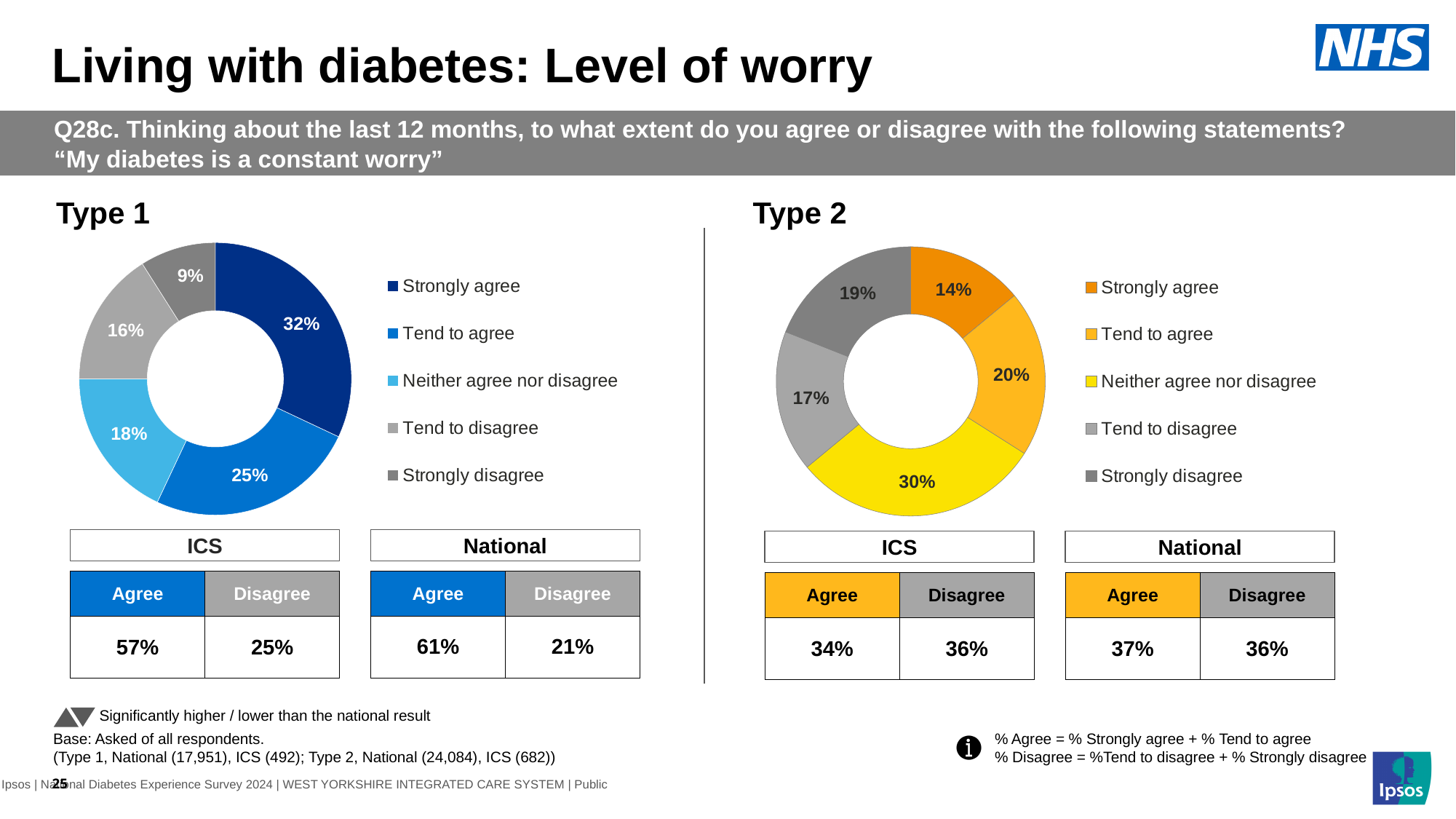
In the Type 1 chart, what is the difference between the Tend to agree and Tend to disagree shares? 9 percentage points In the Type 2 chart, what percentage of respondents neither agree nor disagree? 30% In the Type 1 chart, which response category has the largest share? Strongly agree In the Type 1 chart, what is the combined share of Strongly agree and Tend to agree? 57% In the Type 2 chart, which response category has the smallest share? Strongly agree In the Type 1 chart, what is the National Agree percentage? 61% What kind of chart is used for the Type 2 data? Doughnut (pie) chart How many response categories does the Type 1 chart's legend list? 5 In the Type 2 chart, which is larger: Strongly disagree or Tend to disagree? Strongly disagree In the Type 2 chart, what is the ICS Disagree percentage? 36% In the Type 1 chart, what percentage of respondents strongly agree? 32% In the Type 1 chart, what colour represents Strongly agree? Dark blue